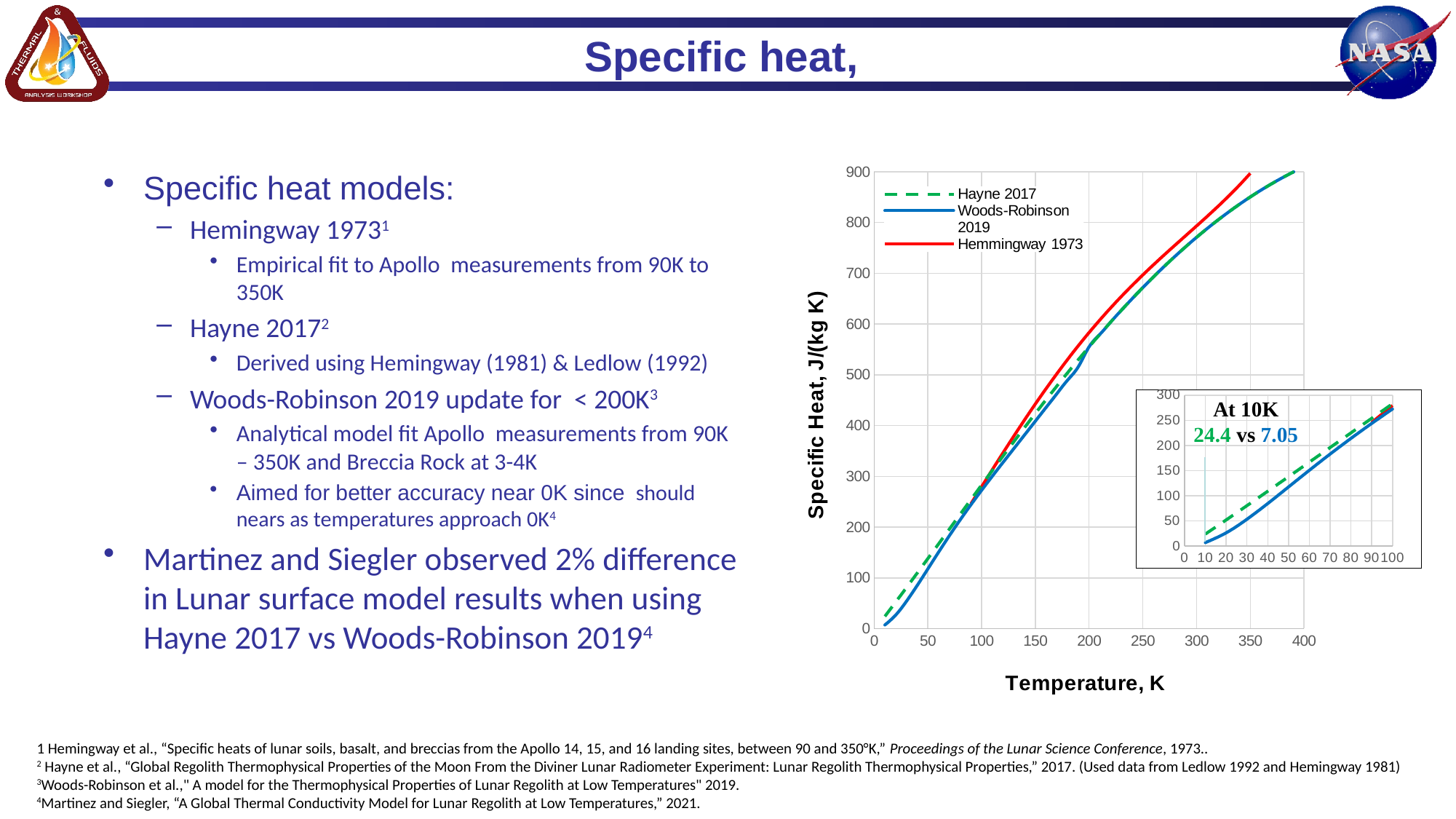
Is the Woods-Robinson 2019 value at 50 K greater or less than 200? less What kind of chart is shown on the slide? line chart Which series are listed in the legend of the main chart? Hayne 2017, Woods-Robinson 2019, Hemmingway 1973 Do the specific heat values rise or fall as temperature increases along the x axis? rise Which series has the highest specific heat at 300 K on the main chart? Hemmingway 1973 At 10K, which model gives the larger specific heat, Hayne 2017 or Woods-Robinson 2019? Hayne 2017 How many series does the legend of the main chart list? 3 What is the label of the y axis of the main chart? Specific Heat, J/(kg K) Is the Hemmingway 1973 value at 300 K greater or less than 700? greater According to the inset annotation, what is the specific heat of the Woods-Robinson 2019 model at 10K? 7.05 According to the inset annotation, what is the specific heat of the Hayne 2017 model at 10K? 24.4 What is the difference between the Hayne 2017 and Woods-Robinson 2019 specific heat values at 10K shown in the inset? 17.35